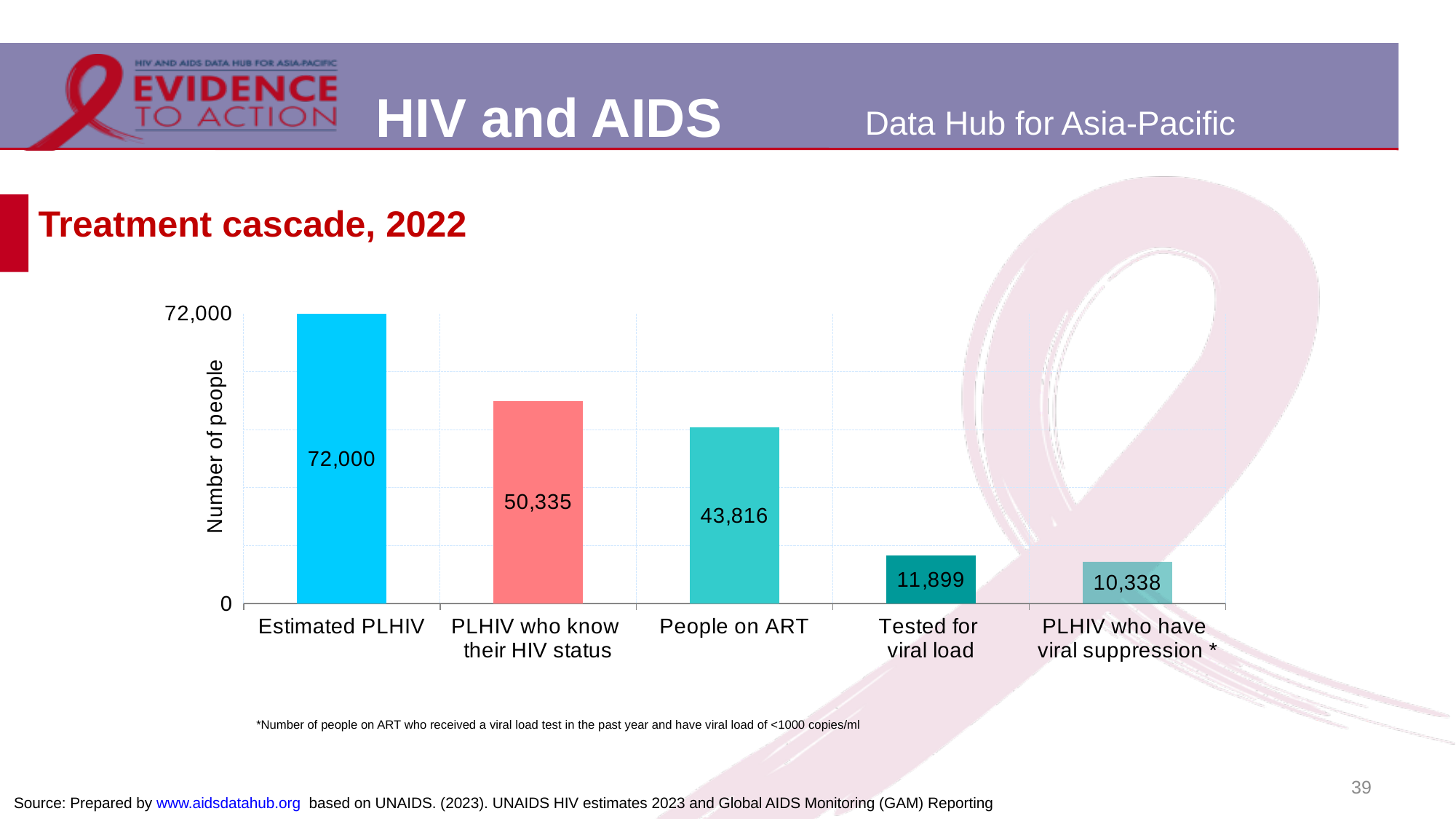
What is the value for Tested for viral load? 11,899 What is the value for PLHIV who know their HIV status? 50,335 What is the value for Estimated PLHIV? 72,000 Which is larger, People on ART or Tested for viral load? People on ART What is the difference between Tested for viral load and PLHIV who have viral suppression? 1,561 Which category has the lowest value? PLHIV who have viral suppression What is the difference between Estimated PLHIV and PLHIV who know their HIV status? 21,665 What is the value for PLHIV who have viral suppression? 10,338 What kind of chart is shown on the slide? Bar chart What is the value for People on ART? 43,816 Which category has the highest value? Estimated PLHIV How many categories are shown on the x axis? 5